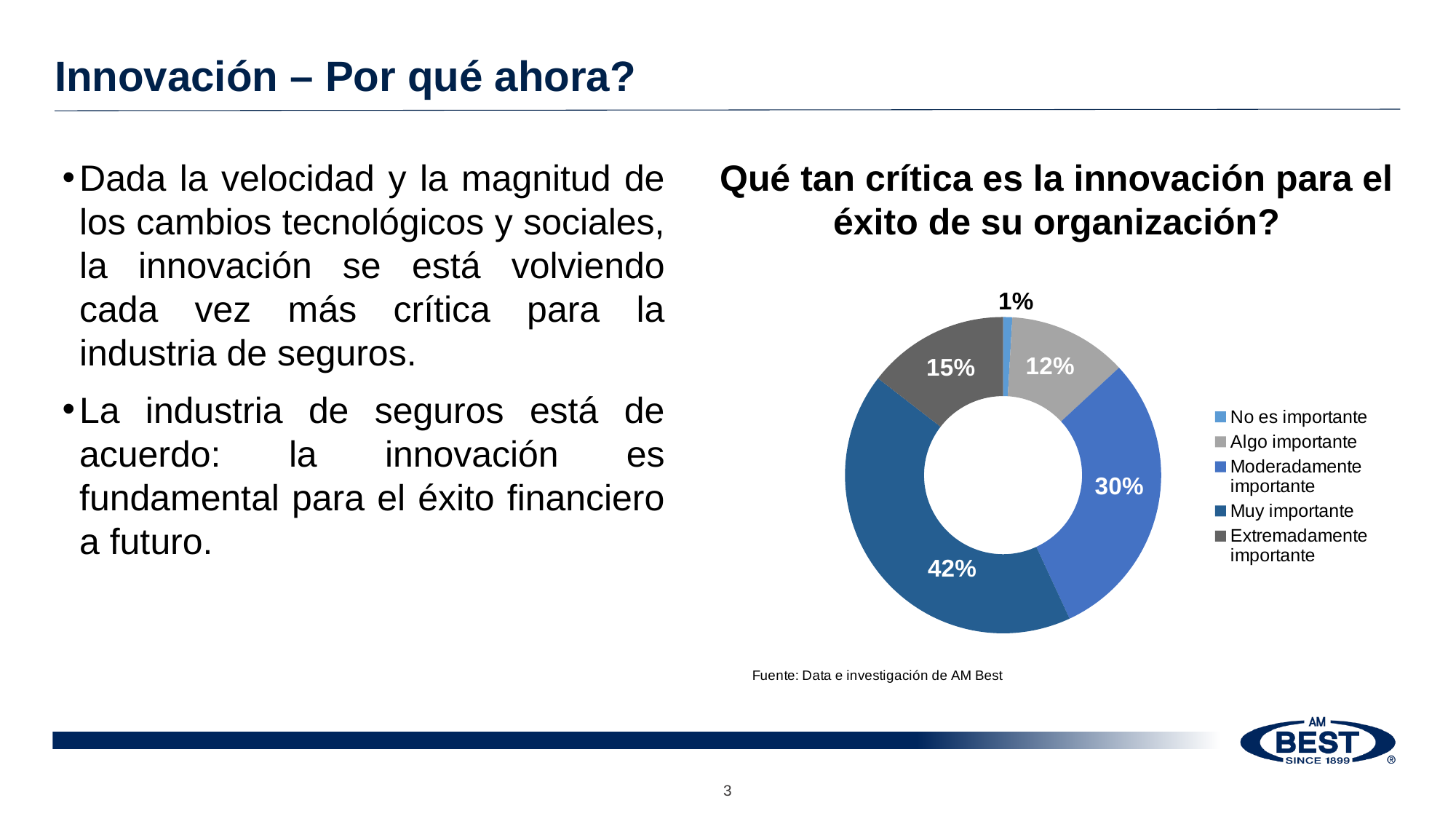
What kind of chart is shown on the slide? Pie chart (doughnut) Which category has the largest share of the chart? Muy importante Which is larger: the share for 'Extremadamente importante' or for 'Algo importante'? Extremadamente importante What is the title of the chart? Qué tan crítica es la innovación para el éxito de su organización? What percentage of respondents said innovation is 'No es importante'? 1% What percentage of respondents said innovation is 'Algo importante'? 12% How many categories does the chart show? 5 What percentage of respondents said innovation is 'Muy importante'? 42% What is the difference in percentage points between 'Muy importante' and 'Moderadamente importante'? 12 Which category has the smallest share of the chart? No es importante What percentage of respondents said innovation is 'Moderadamente importante'? 30% What percentage of respondents said innovation is 'Extremadamente importante'? 15%